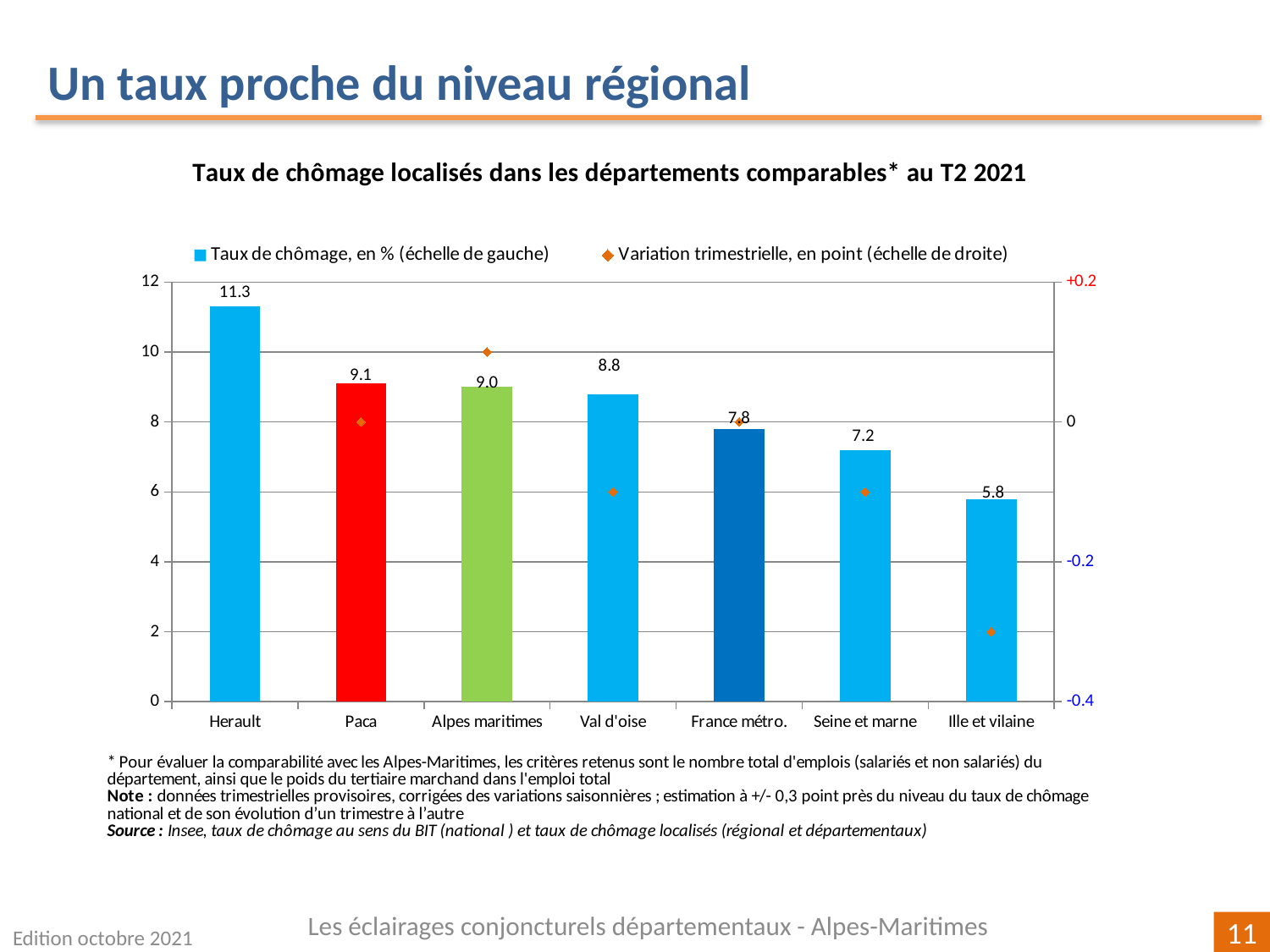
Is the quarterly variation (right-hand scale) for Alpes maritimes greater or less than 0? greater What is the unemployment rate shown for Ille et vilaine? 5.8 How many series does the chart legend list? 2 Which department or area has the highest unemployment rate on the chart? Herault Is the quarterly variation (right-hand scale) for Ille et vilaine greater or less than -0.2? less What is the difference between the unemployment rate of Hérault and that of Paca? 2.2 How many departments or areas are shown on the x axis of the chart? 7 What is the unemployment rate shown for Hérault? 11.3 What is the title of the chart? Taux de chômage localisés dans les départements comparables* au T2 2021 What is the unemployment rate shown for Alpes maritimes? 9.0 Which department or area has the lowest unemployment rate on the chart? Ille et vilaine Which has a higher unemployment rate, Val d'oise or Seine et marne? Val d'oise